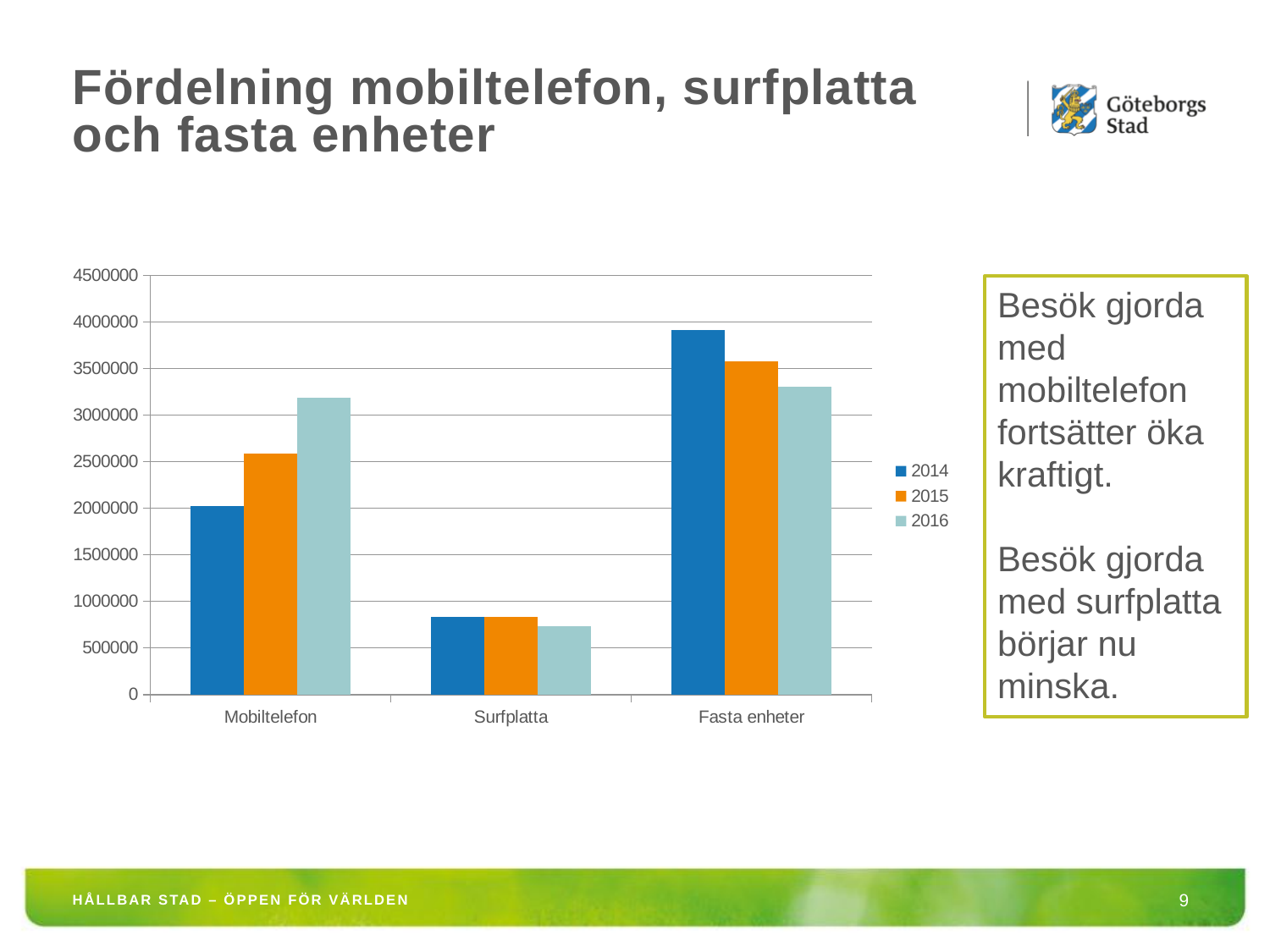
Is the value for Surfplatta in 2016 greater or less than 1000000? less What kind of chart is shown on the slide? bar chart Which category has the highest value for 2014? Fasta enheter Which category has the lowest value for 2016? Surfplatta How many categories are shown on the x axis of the chart? 3 Is the value for Fasta enheter in 2016 greater or less than 3500000? less Do the values for Mobiltelefon rise or fall from 2014 to 2016? rise Which is larger in 2016, the value for Mobiltelefon or the value for Fasta enheter? Fasta enheter Do the values for Fasta enheter rise or fall from 2014 to 2016? fall Is the value for Mobiltelefon in 2016 greater or less than 3000000? greater How many series does the chart's legend list? 3